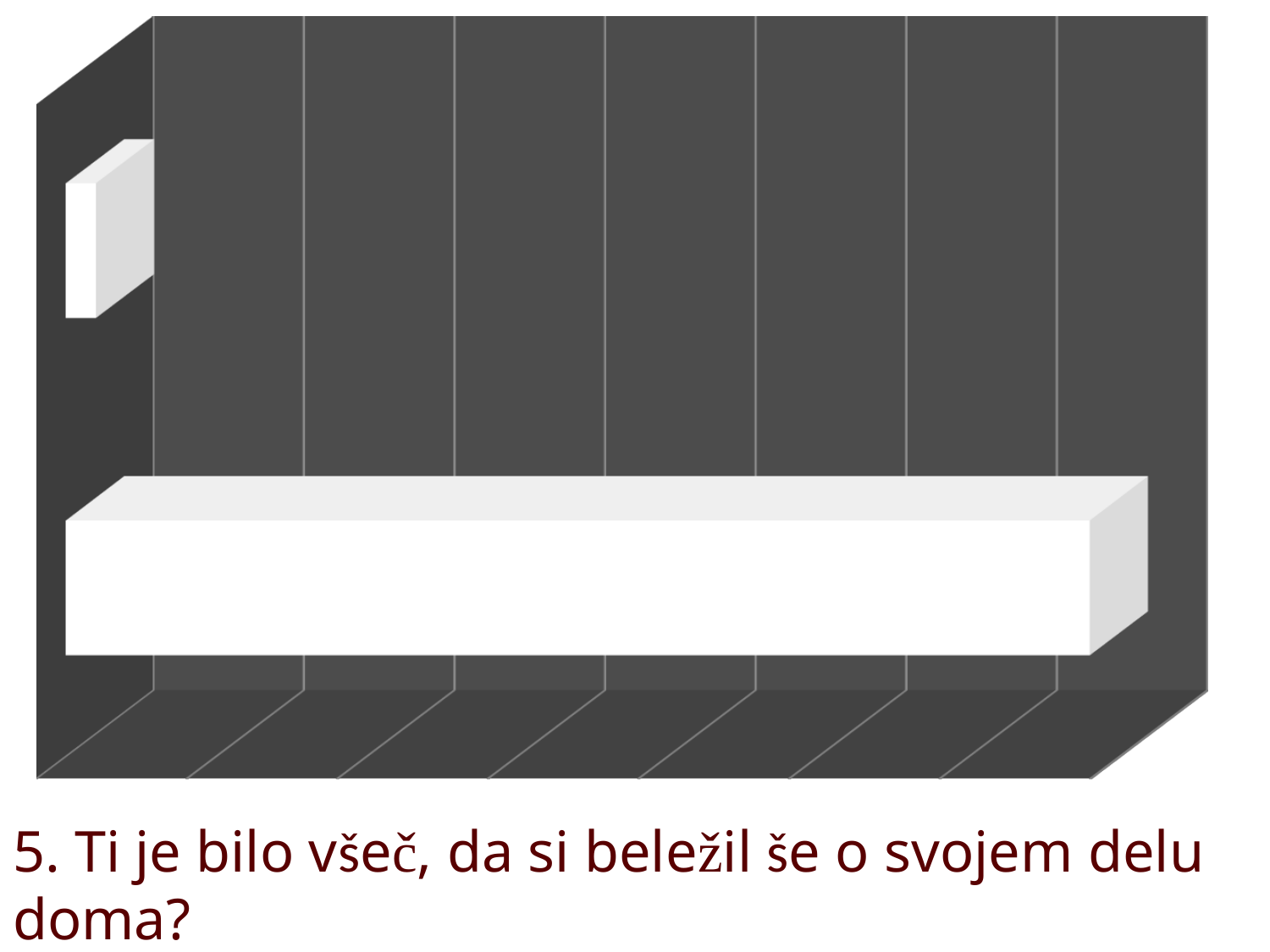
What kind of chart is shown on the slide? bar chart How many bars are plotted in the chart? 2 Which bar represents the smallest value in the chart? the top bar Which bar represents the largest value in the chart? the bottom bar Which bar is longer, the top bar or the bottom bar? the bottom bar What question text is shown beneath the chart? 5. Ti je bilo všeč, da si beležil še o svojem delu doma? Are the bars in the chart oriented horizontally or vertically? horizontally